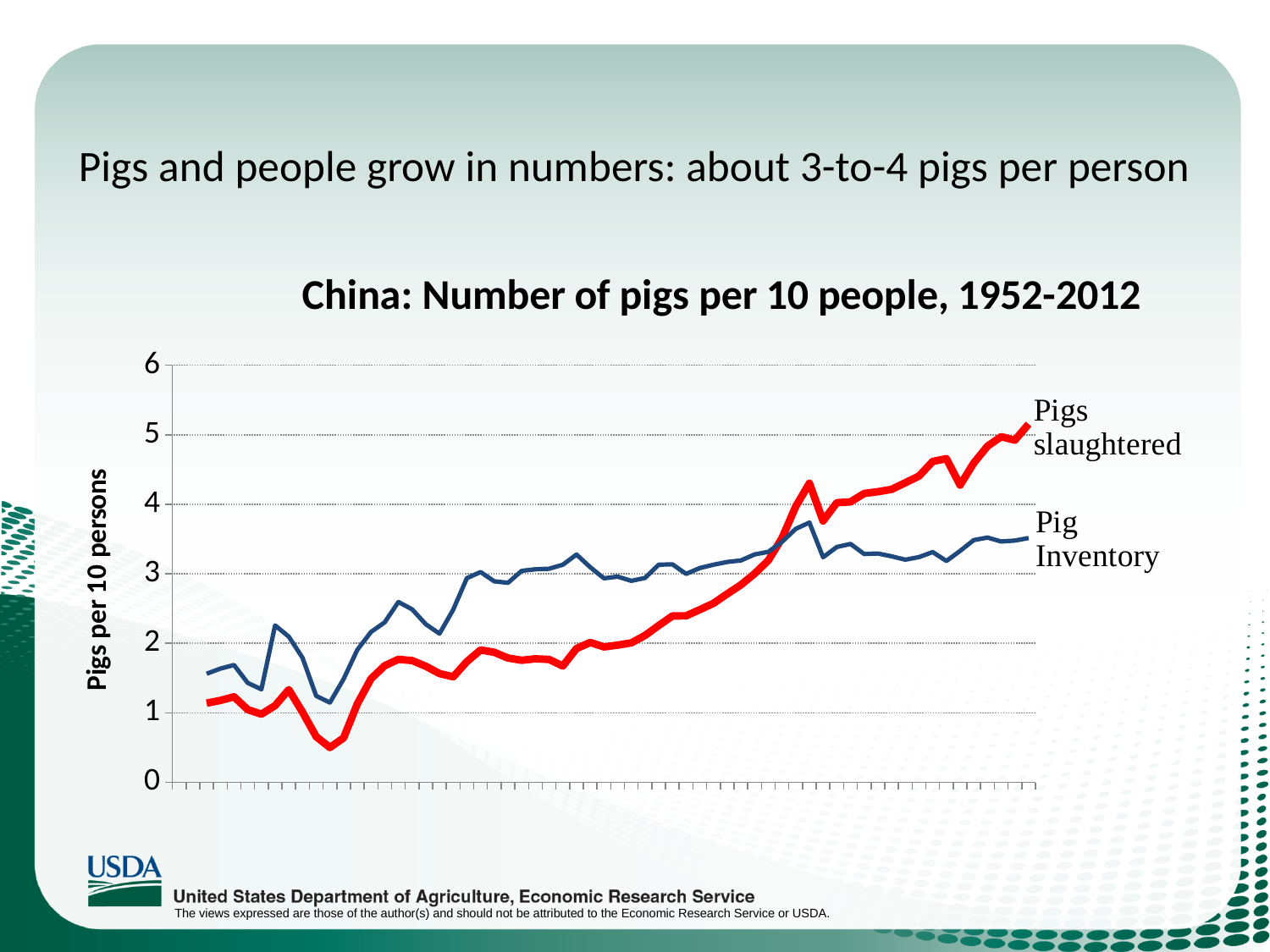
Is the value of Pigs slaughtered at the right end of the chart greater or less than 4? greater Is the value of Pig Inventory at the right end of the chart greater or less than 4? less Which series reaches the highest value on the chart? Pigs slaughtered What kind of chart is shown on the slide? line chart What is the label on the vertical axis of the chart? Pigs per 10 persons Is the lowest value of the Pigs slaughtered series greater or less than 1? less Does the Pigs slaughtered series rise or fall overall from left to right? rise How many series are plotted on the chart? 2 Does the Pig Inventory series rise or fall overall from left to right? rise What is the title of the chart? China: Number of pigs per 10 people, 1952-2012 At the right end of the chart, which series is higher: Pigs slaughtered or Pig Inventory? Pigs slaughtered At the left end of the chart, which series is higher: Pigs slaughtered or Pig Inventory? Pig Inventory